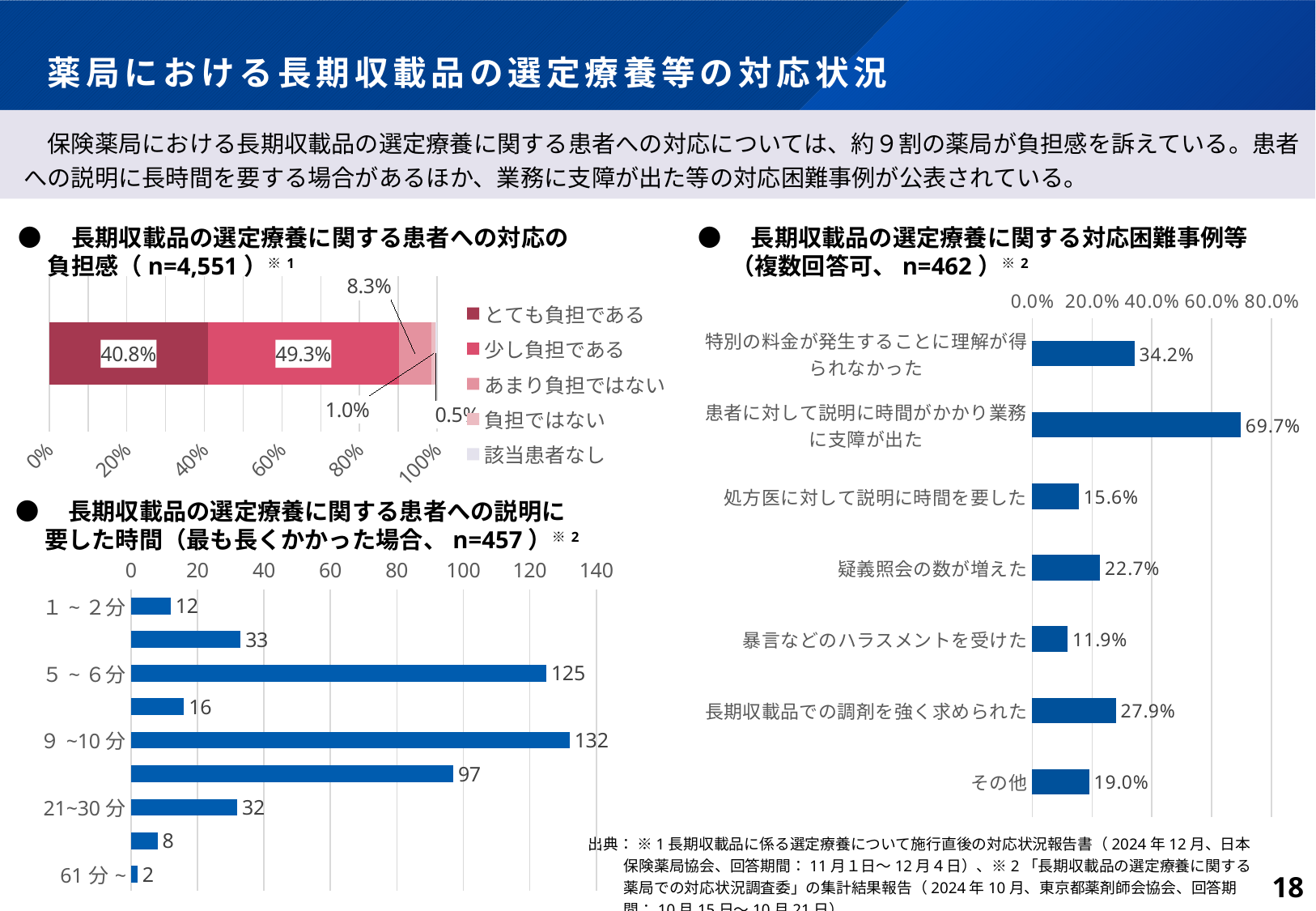
In the chart titled 「長期収載品の選定療養に関する患者への対応の負担感」, what percentage is shown for 「とても負担である」? 40.8% In the chart titled 「長期収載品の選定療養に関する対応困難事例等」, what percentage is shown for 「患者に対して説明に時間がかかり業務に支障が出た」? 69.7% In the chart titled 「長期収載品の選定療養に関する対応困難事例等」, which category has the lowest value? 暴言などのハラスメントを受けた In the chart titled 「長期収載品の選定療養に関する患者への対応の負担感」, what is the combined percentage of 「とても負担である」 and 「少し負担である」? 90.1% In the chart titled 「長期収載品の選定療養に関する患者への説明に要した時間」, how many bars are plotted? 9 In the chart titled 「長期収載品の選定療養に関する患者への対応の負担感」, what percentage is shown for 「少し負担である」? 49.3% In the chart titled 「長期収載品の選定療養に関する対応困難事例等」, which is larger: 「疑義照会の数が増えた」 or 「長期収載品での調剤を強く求められた」? 長期収載品での調剤を強く求められた In the chart titled 「長期収載品の選定療養に関する患者への説明に要した時間」, what is the value for 「9～10分」? 132 In the chart titled 「長期収載品の選定療養に関する患者への説明に要した時間」, what is the value for 「61分～」? 2 In the chart titled 「長期収載品の選定療養に関する患者への対応の負担感」, how many entries does the legend list? 5 In the chart titled 「長期収載品の選定療養に関する患者への説明に要した時間」, which category has the highest value? 9～10分 In the chart titled 「長期収載品の選定療養に関する患者への説明に要した時間」, what is the difference between the values for 「5～6分」 and 「1～2分」? 113